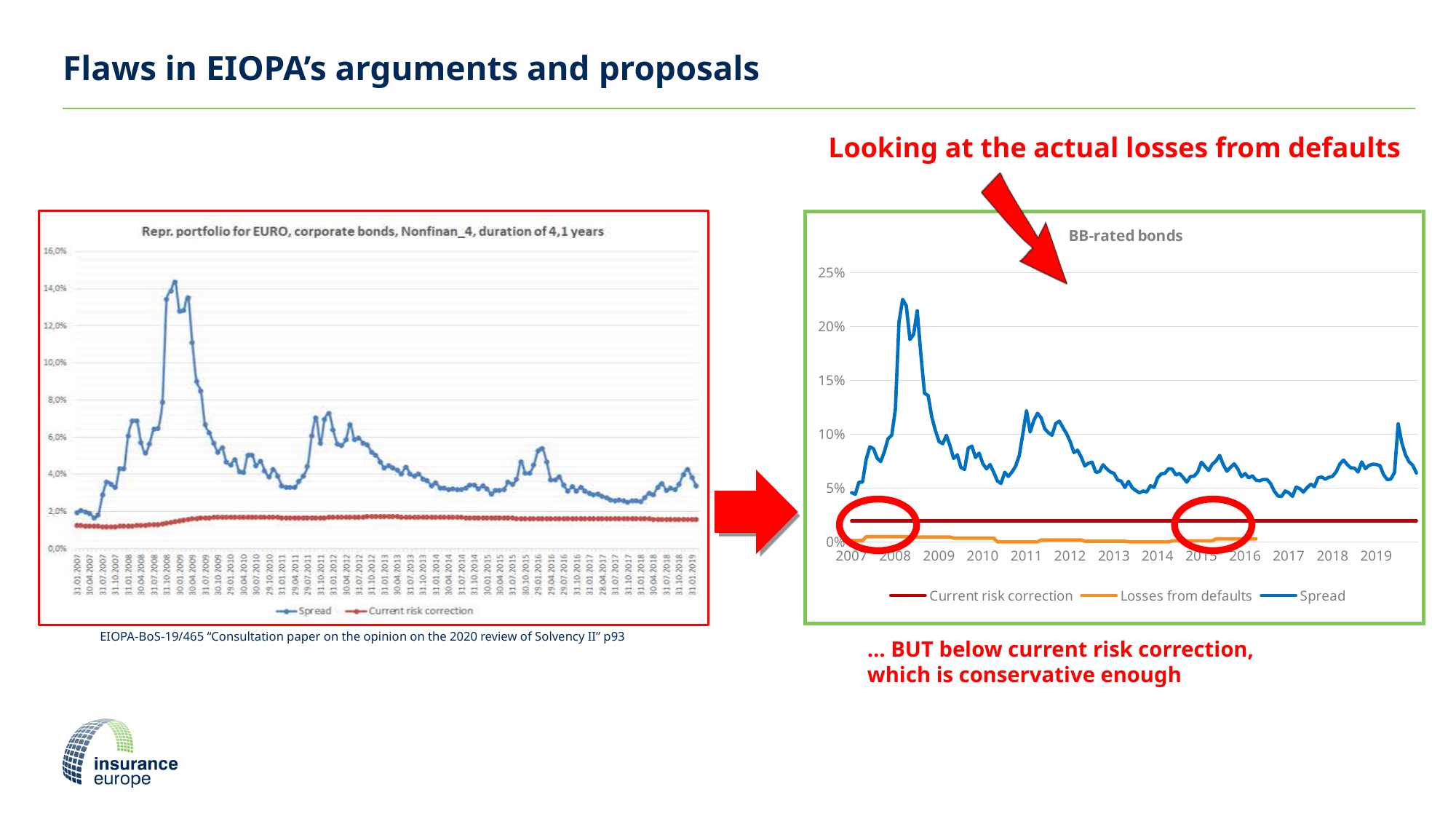
In the left chart, is the peak value of the Spread series around early 2009 greater or less than 12,0%? greater How many series does the legend of the right chart "BB-rated bonds" list? 3 In the right chart "BB-rated bonds", is the peak value of the Spread series in 2008 greater or less than 20%? greater Which series in the right chart "BB-rated bonds" is drawn in orange? Losses from defaults In the right chart "BB-rated bonds", is the Current risk correction line greater or less than 5%? less What type of chart is the right chart titled "BB-rated bonds"? Line chart In the right chart "BB-rated bonds", which series reaches the highest value? Spread In the right chart "BB-rated bonds", which series has the lowest values? Losses from defaults In the right chart "BB-rated bonds", which is larger in 2008: the Spread or the Current risk correction? Spread In the right chart "BB-rated bonds", does the Spread series rise or fall from its 2008 peak to 2010? Fall What type of chart is the left chart titled "Repr. portfolio for EURO, corporate bonds, Nonfinan_4, duration of 4,1 years"? Line chart How many series does the legend of the left chart list? 2